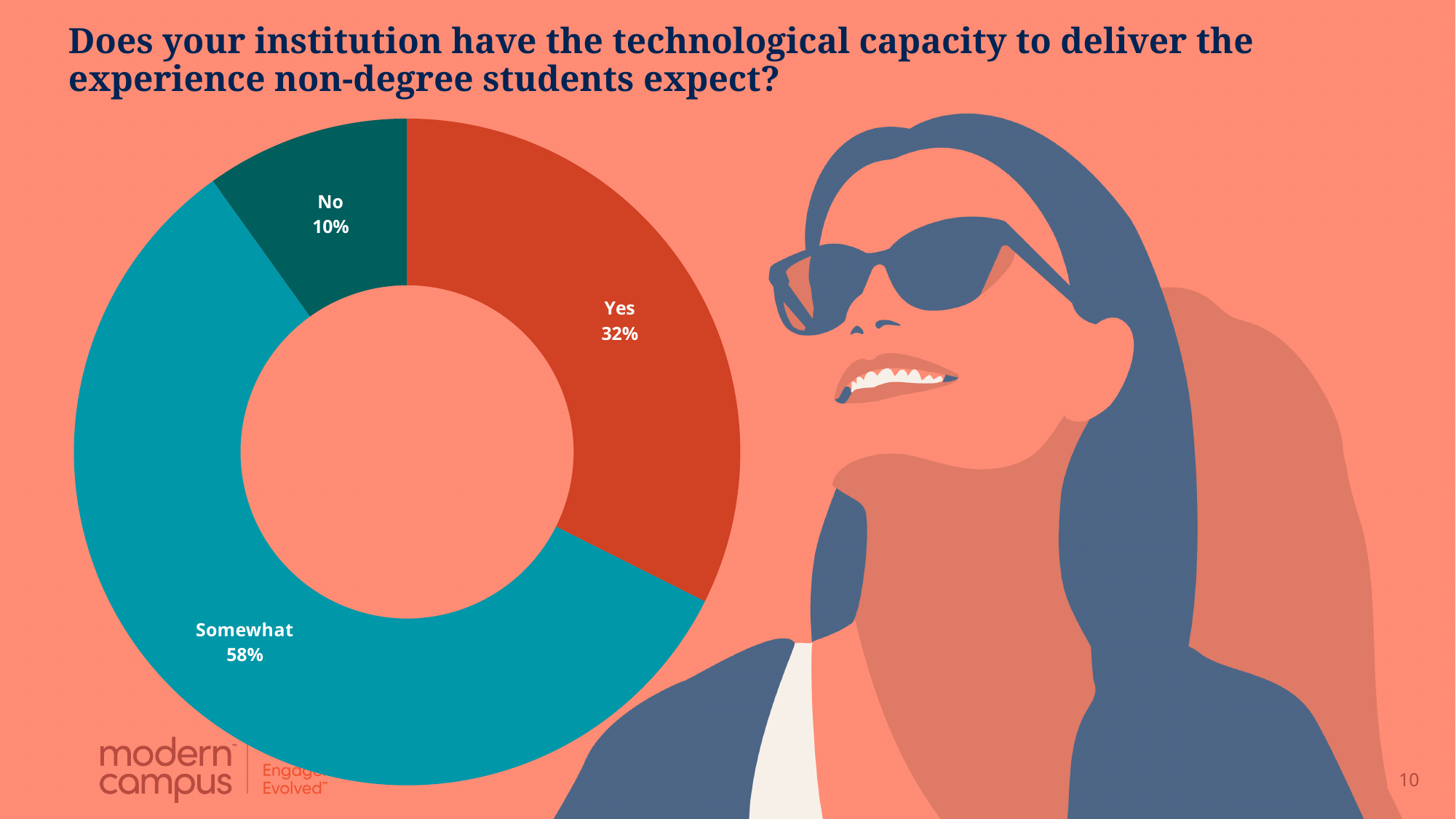
What is the difference in percentage points between "Somewhat" and "Yes"? 26 What percentage of respondents answered "Yes"? 32% How many response categories are shown in the chart? 3 What is the difference in percentage points between "Yes" and "No"? 22 What percentage of respondents answered "No"? 10% What colour is the "Yes" slice? Red Which response has the smallest share of the chart? No Which response has the largest share of the chart? Somewhat What share of the pie does the "Somewhat" slice represent? 58% What percentage of respondents answered "Somewhat"? 58% What kind of chart is shown on the slide? Pie chart (donut) Which is larger, the share for "Yes" or the share for "No"? Yes